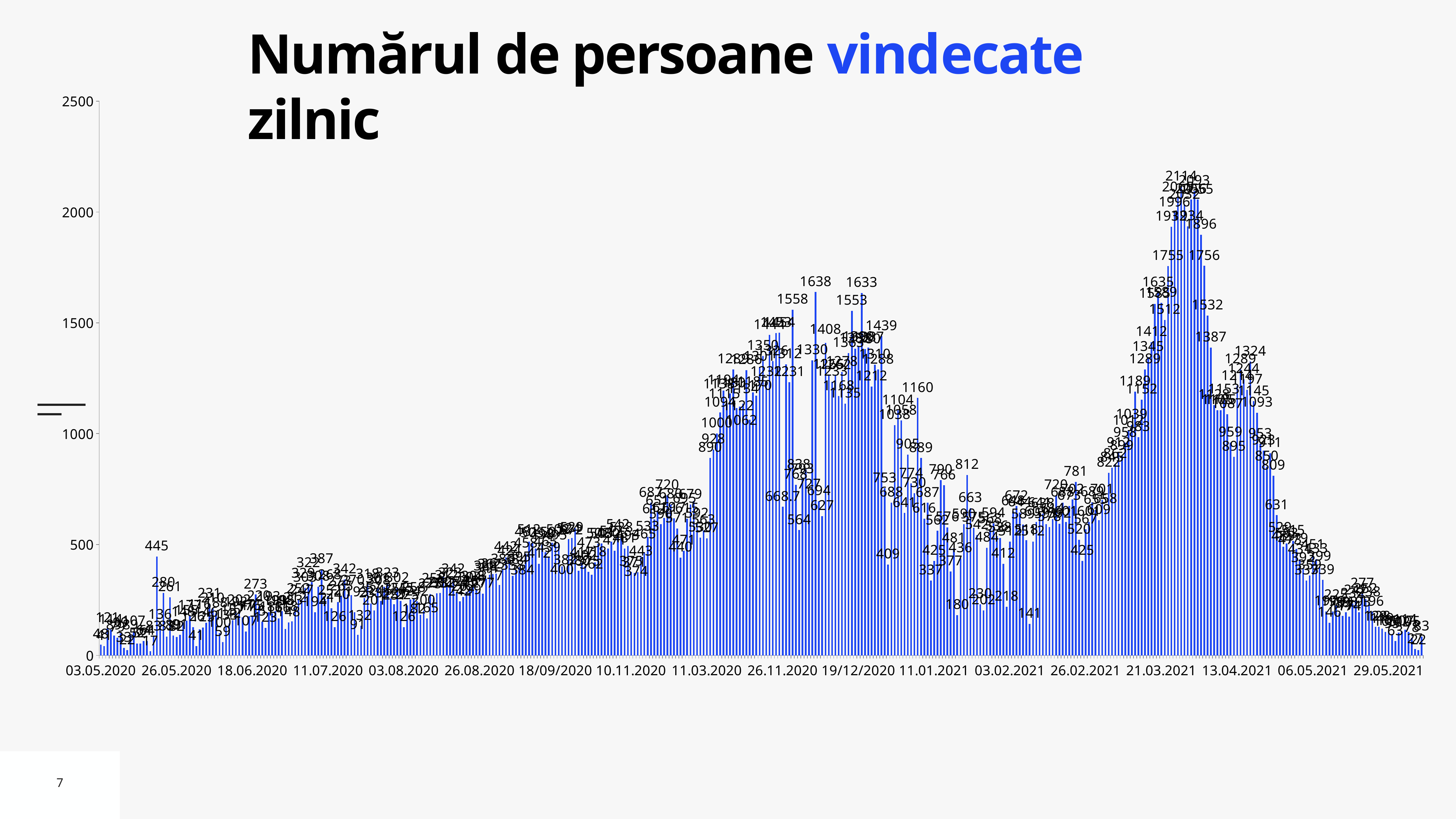
What is the first date label on the horizontal axis? 03.05.2020 Is the peak bar between 26.11.2020 and 19/12/2020, labelled 1638, greater or less than 1500? greater What is the last date label on the horizontal axis? 29.05.2021 Is the value of the first bar, at 03.05.2020, greater or less than 500? less Is the tallest bar on the chart greater or less than 2000? greater Do the values rise or fall between 21.03.2021 and 06.05.2021? fall What is the highest value labelled on the chart? 2114 What kind of chart is shown on the slide? bar chart Do the values rise or fall between 26.02.2021 and 21.03.2021? rise What is the highest tick value shown on the vertical axis? 2500 What is the title of the chart? Numărul de persoane vindecate zilnic What is the difference between the highest labelled value (2114) and the peak labelled 1638 between 26.11.2020 and 19/12/2020? 476